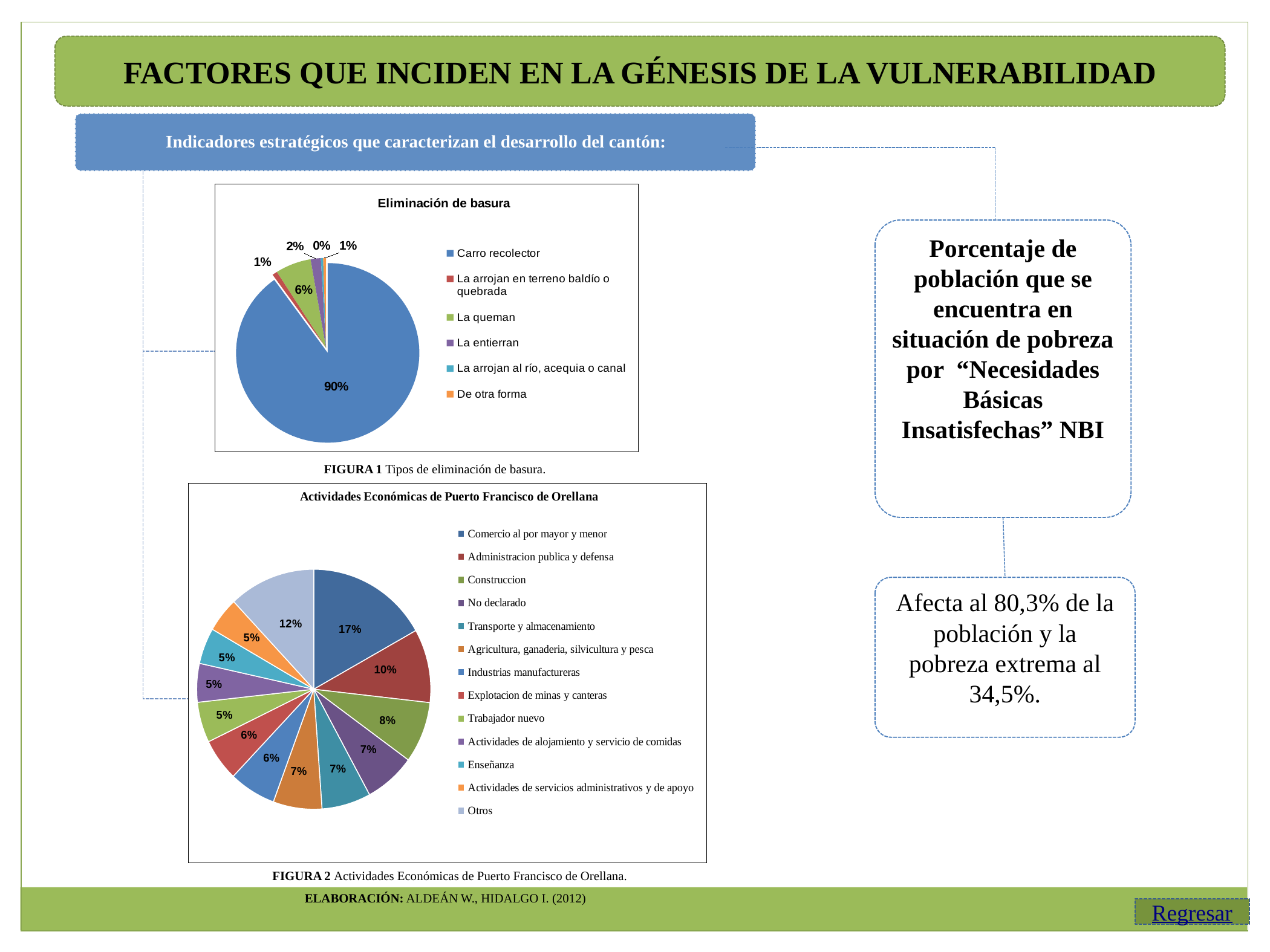
In the 'Actividades Económicas de Puerto Francisco de Orellana' chart, what share does 'Otros' have? 12% In the 'Eliminación de basura' chart, what share does 'Carro recolector' have? 90% In the 'Eliminación de basura' chart, which category has the largest share? Carro recolector In the 'Actividades Económicas de Puerto Francisco de Orellana' chart, what share does 'Administracion publica y defensa' have? 10% In the 'Actividades Económicas de Puerto Francisco de Orellana' chart, what share does 'Comercio al por mayor y menor' have? 17% In the 'Eliminación de basura' chart, how many categories does the legend list? 6 In the 'Actividades Económicas de Puerto Francisco de Orellana' chart, which is larger: 'Administracion publica y defensa' or 'Otros'? Otros In the 'Actividades Económicas de Puerto Francisco de Orellana' chart, how many categories does the legend list? 13 In the 'Actividades Económicas de Puerto Francisco de Orellana' chart, which category has the largest share? Comercio al por mayor y menor In the 'Eliminación de basura' chart, what share does 'La queman' have? 6% In the 'Actividades Económicas de Puerto Francisco de Orellana' chart, what is the difference between the shares of 'Comercio al por mayor y menor' and 'Construccion'? 9% What kind of chart is 'Eliminación de basura'? Pie chart